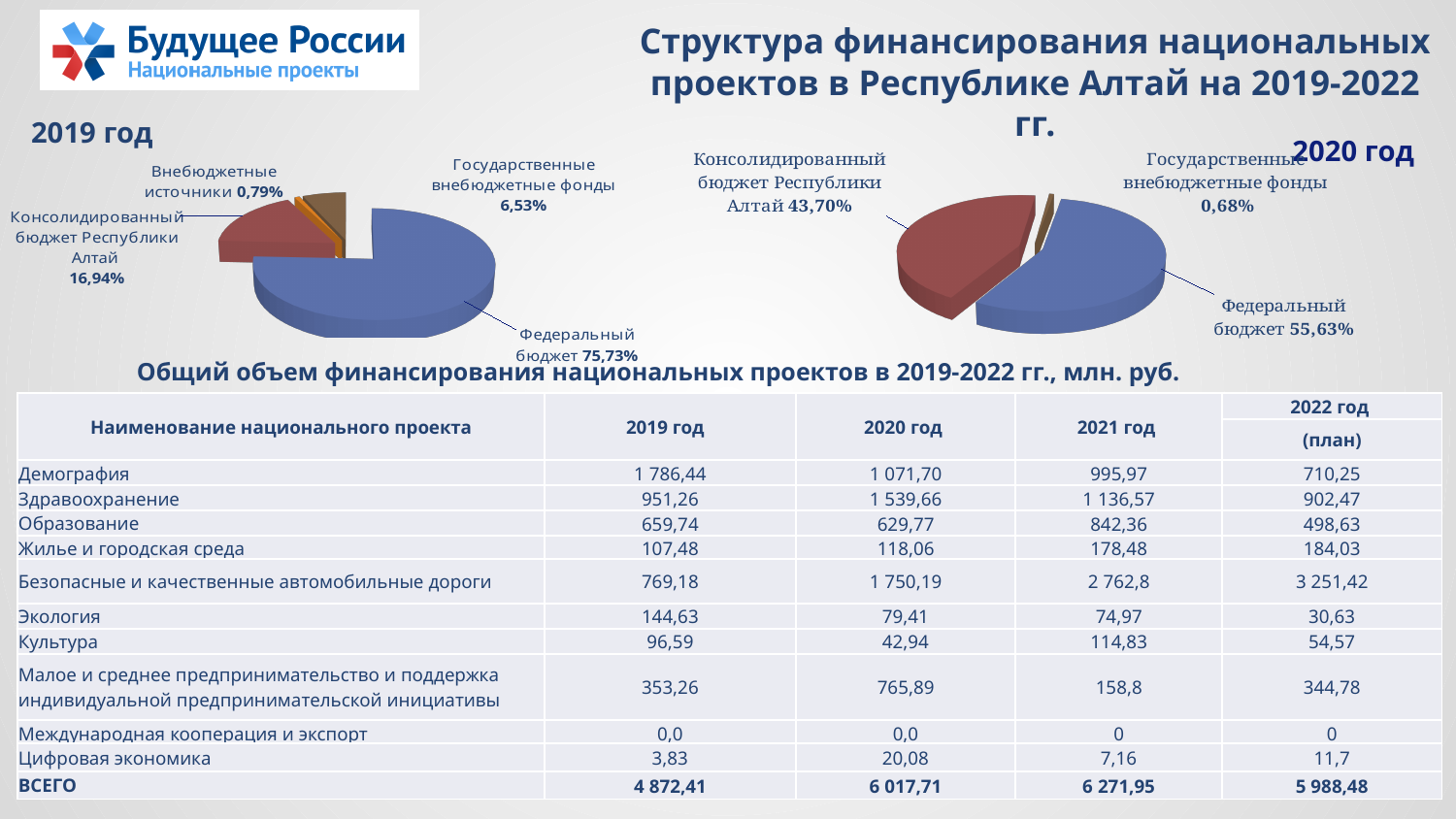
In the 2019 год pie chart, which category has the smallest share? Внебюджетные источники In the 2019 год pie chart, what is the value for Государственные внебюджетные фонды? 6,53% In the 2019 год pie chart, what is the value for Консолидированный бюджет Республики Алтай? 16,94% In the 2020 год pie chart, what is the value for Государственные внебюджетные фонды? 0,68% In the 2020 год pie chart, how many slices are there? 3 In the 2020 год pie chart, what is the difference between Федеральный бюджет and Консолидированный бюджет Республики Алтай? 11,93% Which is larger: Федеральный бюджет in the 2019 год chart or Федеральный бюджет in the 2020 год chart? 2019 год In the 2020 год pie chart, what share does Консолидированный бюджет Республики Алтай have? 43,70% In the 2019 год pie chart, what share does Федеральный бюджет have? 75,73% In the 2020 год pie chart, which category has the largest share? Федеральный бюджет In the 2019 год pie chart, how many slices are there? 4 What type of chart is used for the 2019 год and 2020 год data? Pie chart